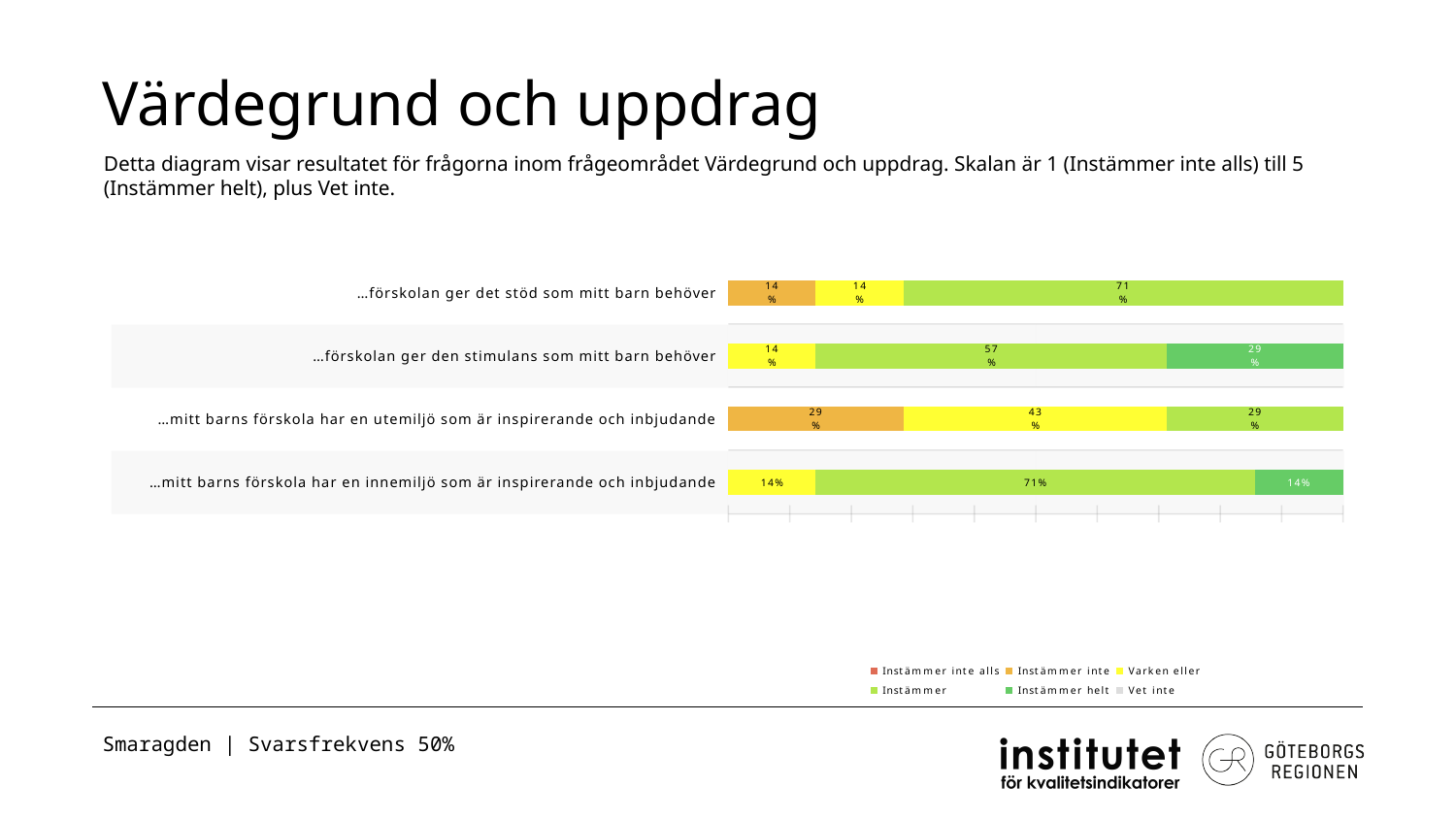
What is the 'Instämmer' share for '…förskolan ger det stöd som mitt barn behöver'? 71% What is the difference between the 'Instämmer' share for '…förskolan ger den stimulans som mitt barn behöver' and the 'Instämmer' share for '…mitt barns förskola har en utemiljö som är inspirerande och inbjudande'? 28% What is the 'Varken eller' share for '…mitt barns förskola har en utemiljö som är inspirerande och inbjudande'? 43% How many series does the legend list? 6 What kind of chart is shown on the slide? Stacked bar chart How many statements (categories) are plotted in the chart? 4 What is the 'Instämmer inte' share for '…mitt barns förskola har en utemiljö som är inspirerande och inbjudande'? 29% Which is larger: the 'Varken eller' share for '…mitt barns förskola har en utemiljö som är inspirerande och inbjudande' or the 'Varken eller' share for '…förskolan ger det stöd som mitt barn behöver'? …mitt barns förskola har en utemiljö som är inspirerande och inbjudande Which statement has the largest 'Instämmer helt' share? …förskolan ger den stimulans som mitt barn behöver What is the total of the printed segments in the bar for '…förskolan ger den stimulans som mitt barn behöver'? 100% What is the 'Instämmer helt' share for '…förskolan ger den stimulans som mitt barn behöver'? 29% What is the 'Instämmer' share for '…mitt barns förskola har en innemiljö som är inspirerande och inbjudande'? 71%